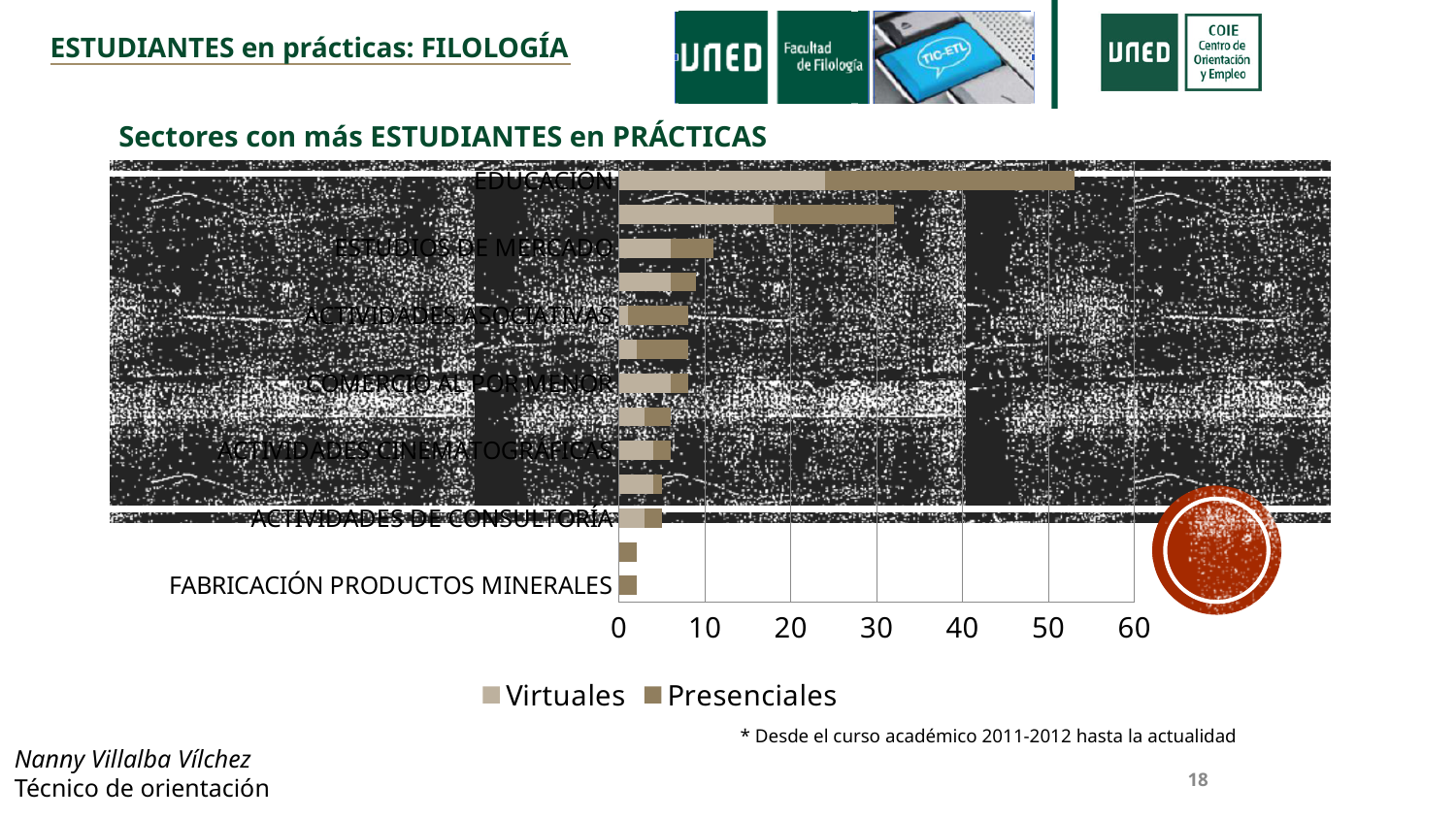
Is the total value for FABRICACIÓN PRODUCTOS MINERALES greater or less than 10? less Do the bar totals rise or fall going from the top category to the bottom category? fall How many series does the chart legend list? 2 Which has a larger total value, EDUCACIÓN or ESTUDIOS DE MERCADO? EDUCACIÓN Which has a larger total value, ACTIVIDADES ASOCIATIVAS or ACTIVIDADES DE CONSULTORÍA? ACTIVIDADES ASOCIATIVAS Is the total value for EDUCACIÓN greater or less than 50? greater Which category has the highest total value in the chart? EDUCACIÓN What kind of chart is shown on the slide? Bar chart Which labeled category has the lowest total value in the chart? FABRICACIÓN PRODUCTOS MINERALES Is the Virtuales value for ESTUDIOS DE MERCADO greater or less than 10? less What are the two series named in the chart legend? Virtuales and Presenciales